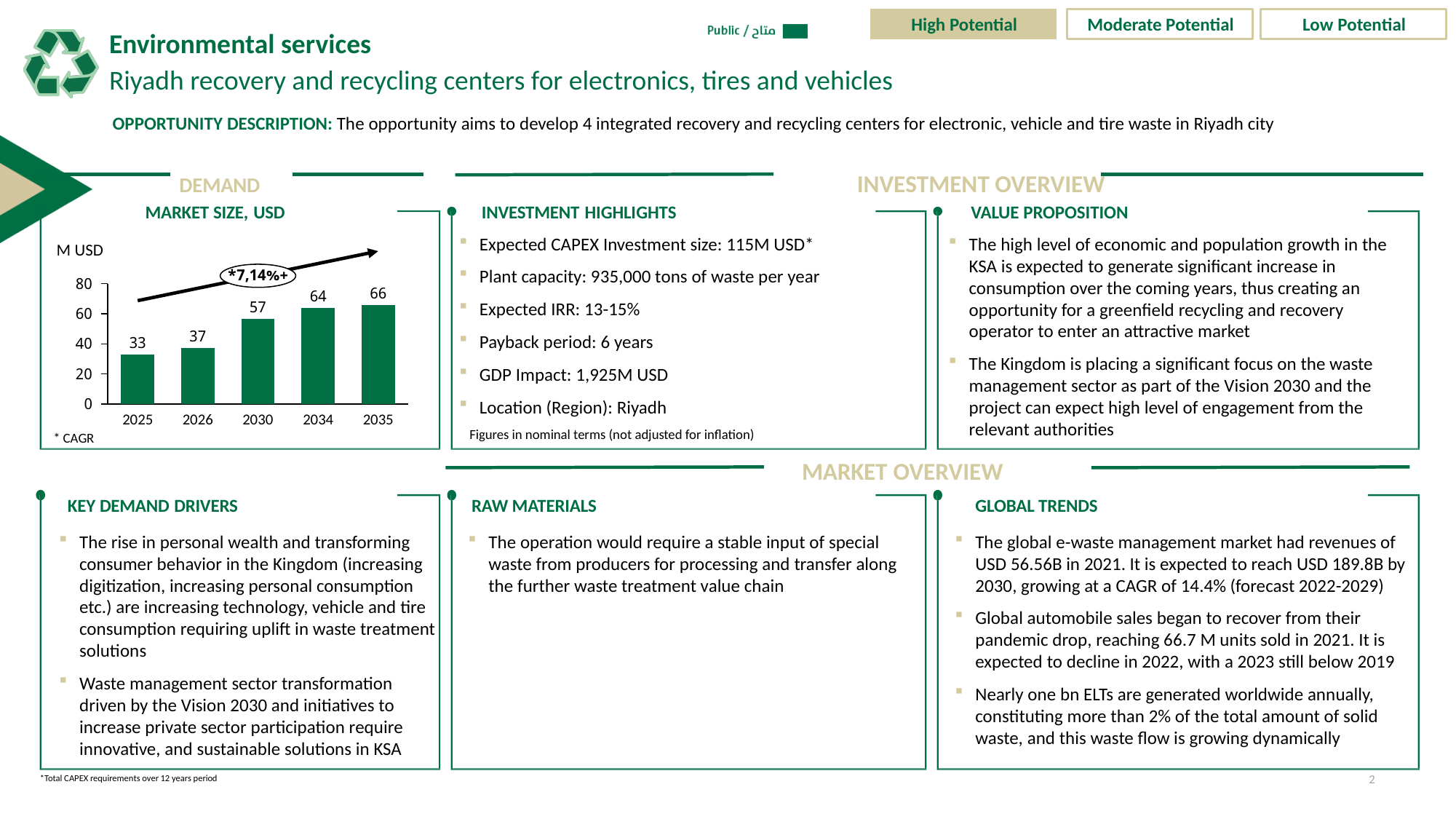
What is the difference between the market size in 2035 and 2025? 33 What is the market size value for 2035? 66 What is the market size value for 2030? 57 Do the market size values rise or fall from 2025 to 2035? rise Which year has the lowest market size? 2025 Is the value for 2034 greater or less than 60? greater What kind of chart is the market size chart? bar chart Which is larger, the market size in 2026 or in 2034? 2034 What CAGR is annotated on the market size chart? *7,14%+ Which year has the highest market size? 2035 What is the market size value for 2025? 33 How many years are shown on the x axis of the market size chart? 5